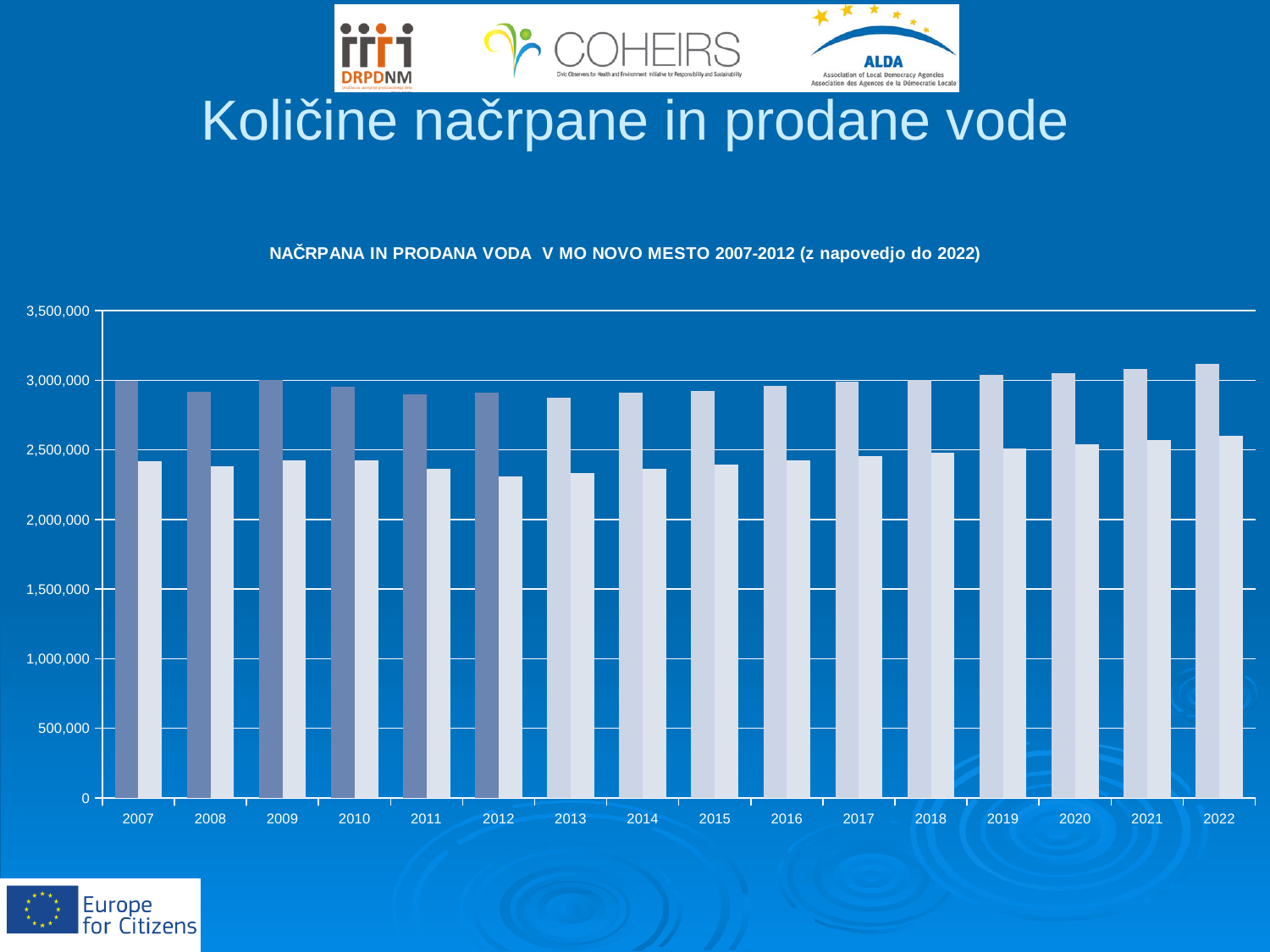
What is the first year shown on the x axis? 2007 How many years are shown on the x axis of the chart? 16 What is the highest value shown on the y axis? 3,500,000 Do the values of the shorter bars rise or fall from 2013 to 2022? rise Is the value of the taller bar for 2022 greater or less than 3,000,000? greater What kind of chart is shown on the slide? bar chart Is the value of the shorter bar for 2022 greater or less than 2,500,000? greater What is the title of the chart? NAČRPANA IN PRODANA VODA V MO NOVO MESTO 2007-2012 (z napovedjo do 2022) Is the value of the shorter bar for 2007 greater or less than 2,500,000? less For 2022, which bar is larger, the left bar or the right bar? the left bar